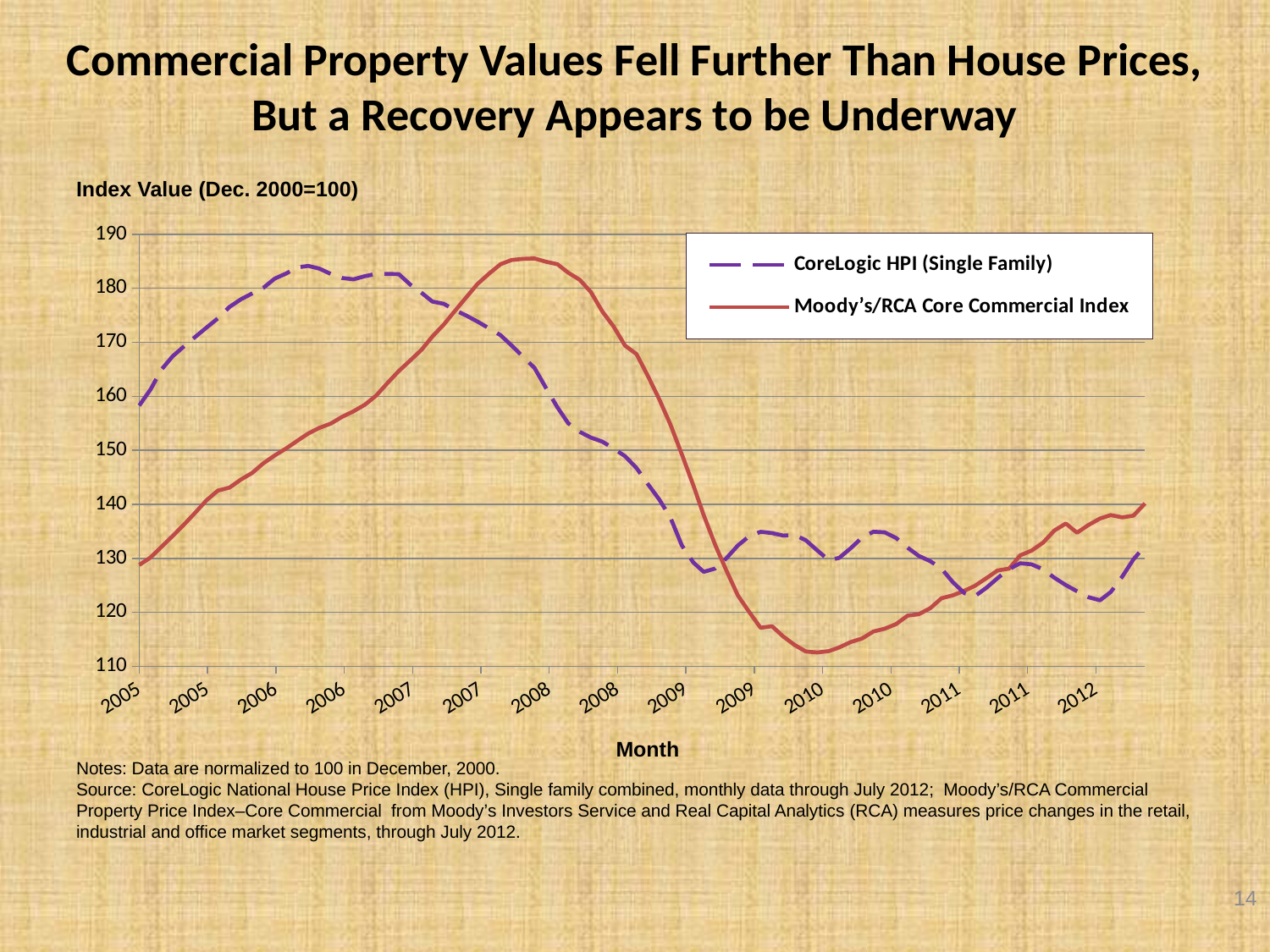
How many series does the legend list? 2 Does the Moody's/RCA Core Commercial Index rise or fall between 2005 and the start of 2008? rise Which series is drawn as a dashed line? CoreLogic HPI (Single Family) Is the value of the Moody's/RCA Core Commercial Index at the end of the series in 2012 greater or less than 130? greater Is the lowest value of the Moody's/RCA Core Commercial Index greater or less than 120? less Is the lowest value of the CoreLogic HPI (Single Family) greater or less than 130? less What kind of chart is shown on the slide? line chart At the start of 2010, which series has the higher value, CoreLogic HPI (Single Family) or Moody's/RCA Core Commercial Index? CoreLogic HPI (Single Family) What are the two series named in the legend? CoreLogic HPI (Single Family) and Moody's/RCA Core Commercial Index Which series fell to a lower trough, CoreLogic HPI (Single Family) or Moody's/RCA Core Commercial Index? Moody's/RCA Core Commercial Index